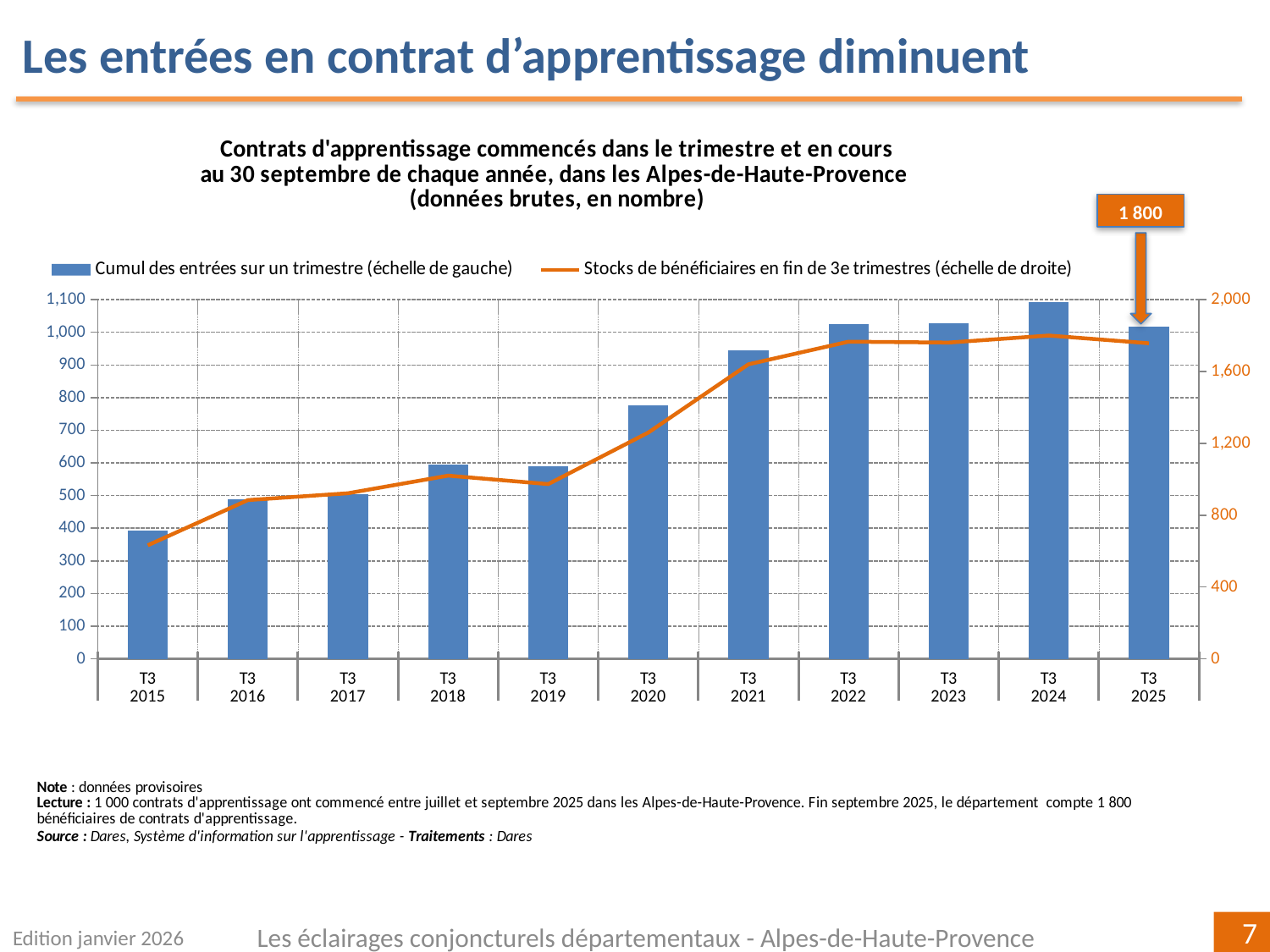
Which axis (left or right) is used for the 'Stocks de bénéficiaires en fin de 3e trimestres' series? right Which bar is taller, T3 2024 or T3 2025? T3 2024 Is the bar value for T3 2024 greater or less than 1,000? greater Does the line for 'Stocks de bénéficiaires' rise or fall between T3 2015 and T3 2022? rise In which quarter is the bar for 'Cumul des entrées sur un trimestre' the highest? T3 2024 In which quarter is the bar for 'Cumul des entrées sur un trimestre' the lowest? T3 2015 How many series does the legend list? 2 Is the bar value for T3 2020 greater or less than 700? greater Is the bar value for T3 2015 greater or less than 500? less What kind of chart is shown on the slide? A combined bar and line chart What is the value of the stock of beneficiaries (Stocks de bénéficiaires) at T3 2025, as shown in the callout? 1 800 How many quarters (categories) are plotted along the x axis? 11